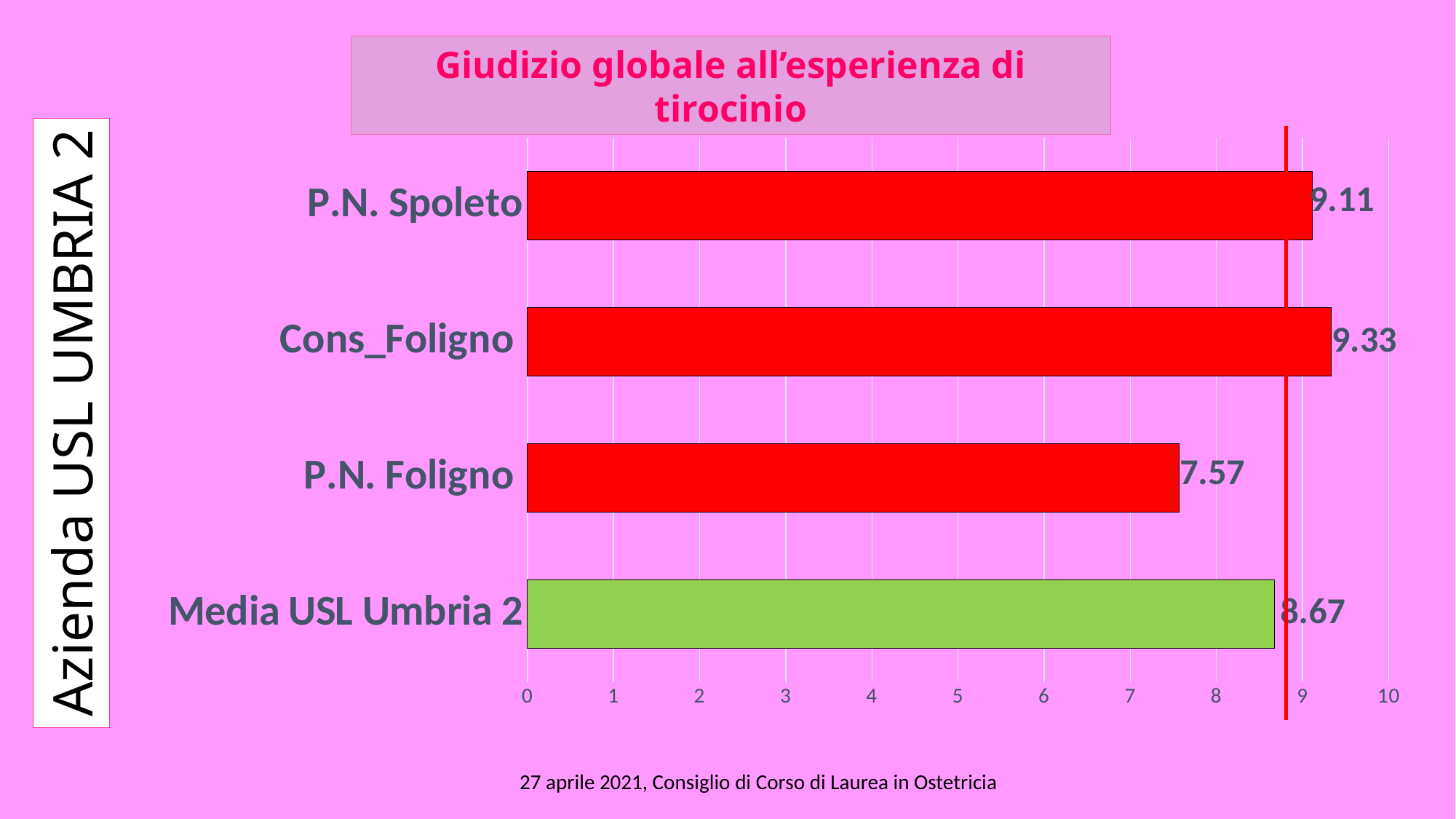
What is the value for Cons_Foligno? 9.33 Is the value for P.N. Foligno greater or less than 8? less What is the difference between the values for Cons_Foligno and P.N. Foligno? 1.76 Which category has the lowest value? P.N. Foligno What is the value for P.N. Spoleto? 9.11 Which is larger, the value for P.N. Spoleto or the value for Media USL Umbria 2? P.N. Spoleto What kind of chart is shown on the slide? bar chart How many categories are shown in the chart? 4 What is the value for P.N. Foligno? 7.57 What is the title of the chart? Giudizio globale all'esperienza di tirocinio Which category has the highest value? Cons_Foligno What is the value for Media USL Umbria 2? 8.67